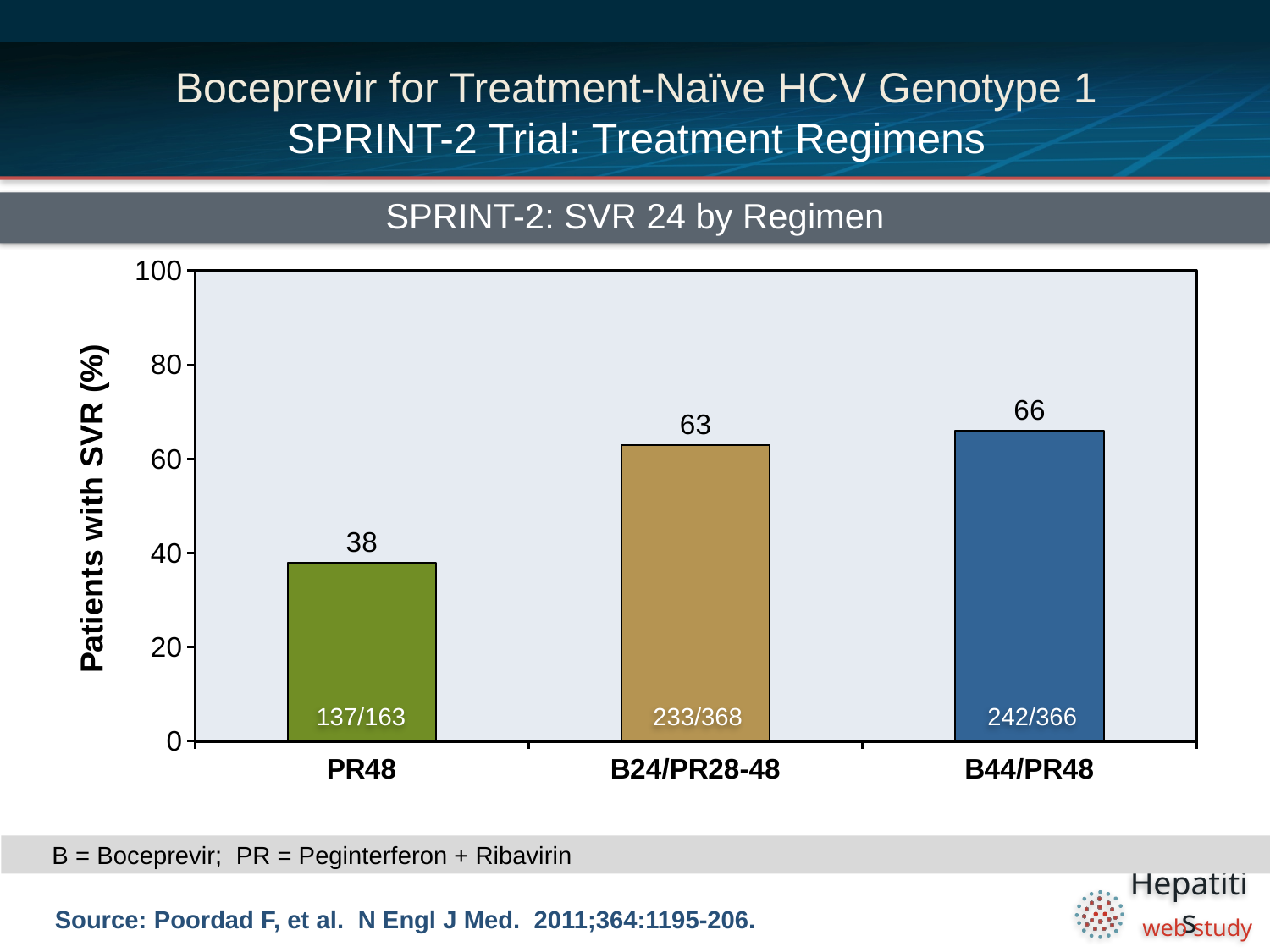
How many regimens are shown in the chart? 3 What is the SVR rate (%) for the B44/PR48 regimen? 66 What fraction of patients is shown inside the PR48 bar? 137/163 What type of chart is shown on the slide? Bar chart What is the difference in SVR rate between B44/PR48 and PR48? 28 What is the difference in SVR rate between B44/PR48 and B24/PR28-48? 3 Which has a higher SVR rate, PR48 or B24/PR28-48? B24/PR28-48 What is the SVR rate (%) for the B24/PR28-48 regimen? 63 What fraction of patients is shown inside the B44/PR48 bar? 242/366 What is the SVR rate (%) for the PR48 regimen? 38 Which regimen has the highest SVR rate? B44/PR48 Which regimen has the lowest SVR rate? PR48